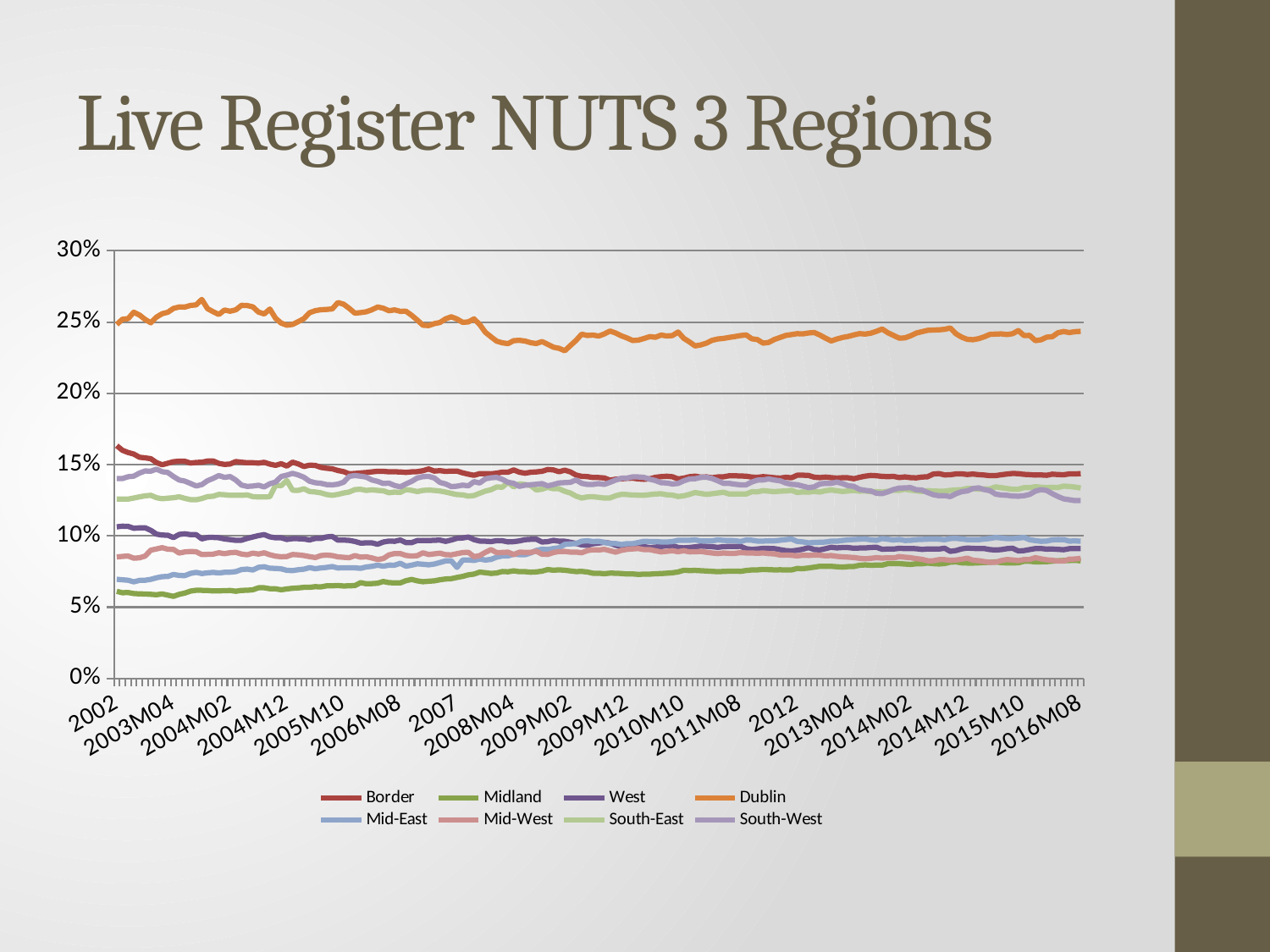
Does the Border line rise or fall from 2002 to 2016M08? fall What kind of chart is shown on the slide? line chart Is the value for Dublin at 2016M08 greater or less than 25%? less How many series does the legend list? 8 What is the title of the chart? Live Register NUTS 3 Regions Which is larger in 2002, the value for Border or the value for Midland? Border Is the value for Midland in 2002 greater or less than 10%? less Is the value for Border in 2002 greater or less than 15%? greater Which region has the highest share throughout the whole period? Dublin Which region has the lowest share at the start of the period in 2002? Midland Does the Midland line rise or fall from 2002 to 2016M08? rise